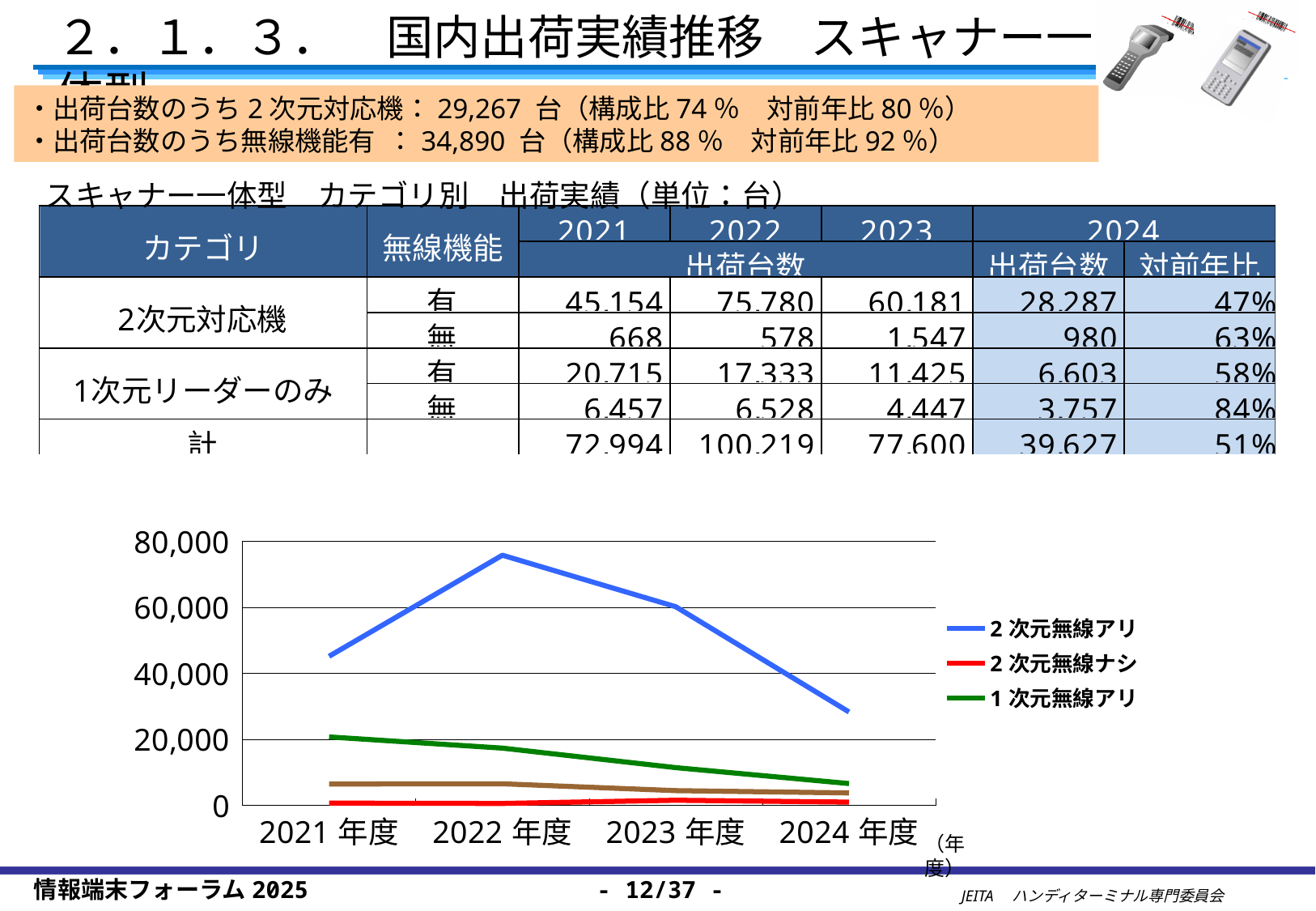
In 2022年度, which is larger: 2次元無線アリ or 1次元無線アリ? 2次元無線アリ What colour is the line for 2次元無線ナシ in the chart? red In which year is the value for 2次元無線アリ highest? 2022年度 In which year is the value for 2次元無線アリ lowest? 2024年度 How many series does the chart's legend list? 3 Is the value for 2次元無線アリ in 2022年度 greater or less than 60,000? greater Is the value for 1次元無線アリ in 2023年度 greater or less than 20,000? less How many years are shown along the x axis of the chart? 4 Does the value for 1次元無線アリ rise or fall from 2021年度 to 2024年度? fall Does the value for 2次元無線アリ rise or fall from 2022年度 to 2024年度? fall What kind of chart is shown on the slide? line chart Is the value for 2次元無線アリ in 2024年度 greater or less than 40,000? less